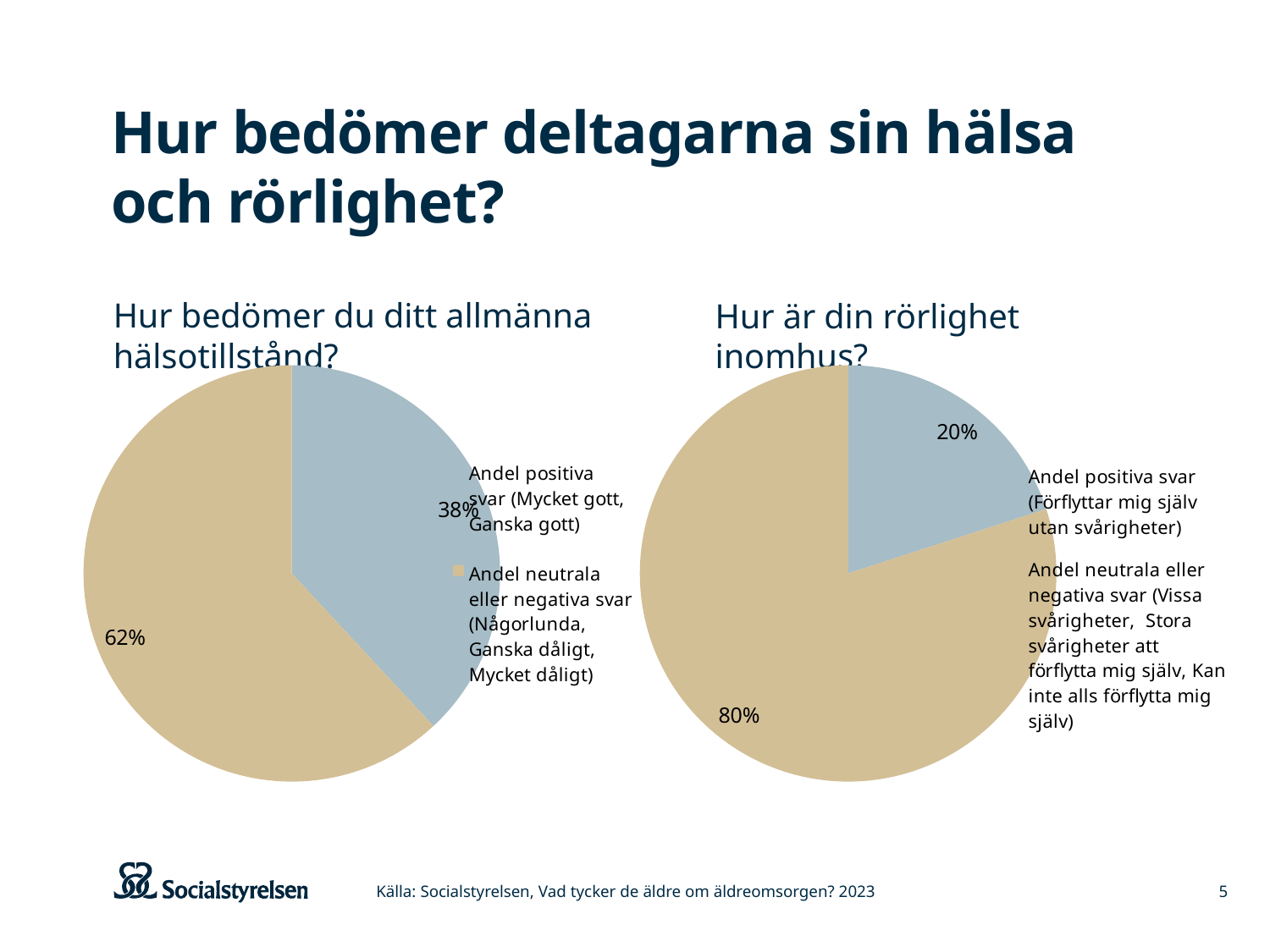
In the left chart 'Hur bedömer du ditt allmänna hälsotillstånd?', which category has the largest slice? Andel neutrala eller negativa svar In the right chart 'Hur är din rörlighet inomhus?', what is the difference in percentage points between the neutral/negative share and the positive share? 60 percentage points In the left chart 'Hur bedömer du ditt allmänna hälsotillstånd?', what share of respondents gave neutral or negative answers? 62% In the left chart 'Hur bedömer du ditt allmänna hälsotillstånd?', what is the difference in percentage points between the neutral/negative share and the positive share? 24 percentage points How many slices does the right chart 'Hur är din rörlighet inomhus?' have? 2 How many charts are shown on the slide? 2 What type of chart is used on this slide? Pie chart In the right chart 'Hur är din rörlighet inomhus?', which category has the smallest slice? Andel positiva svar In the left chart 'Hur bedömer du ditt allmänna hälsotillstånd?', what share of respondents gave positive answers (Andel positiva svar)? 38% In the right chart 'Hur är din rörlighet inomhus?', what share of respondents gave positive answers (Förflyttar mig själv utan svårigheter)? 20% In the right chart 'Hur är din rörlighet inomhus?', what share of respondents gave neutral or negative answers? 80% Which chart shows a larger share of positive answers, the left chart on general health or the right chart on indoor mobility? The left chart (general health)